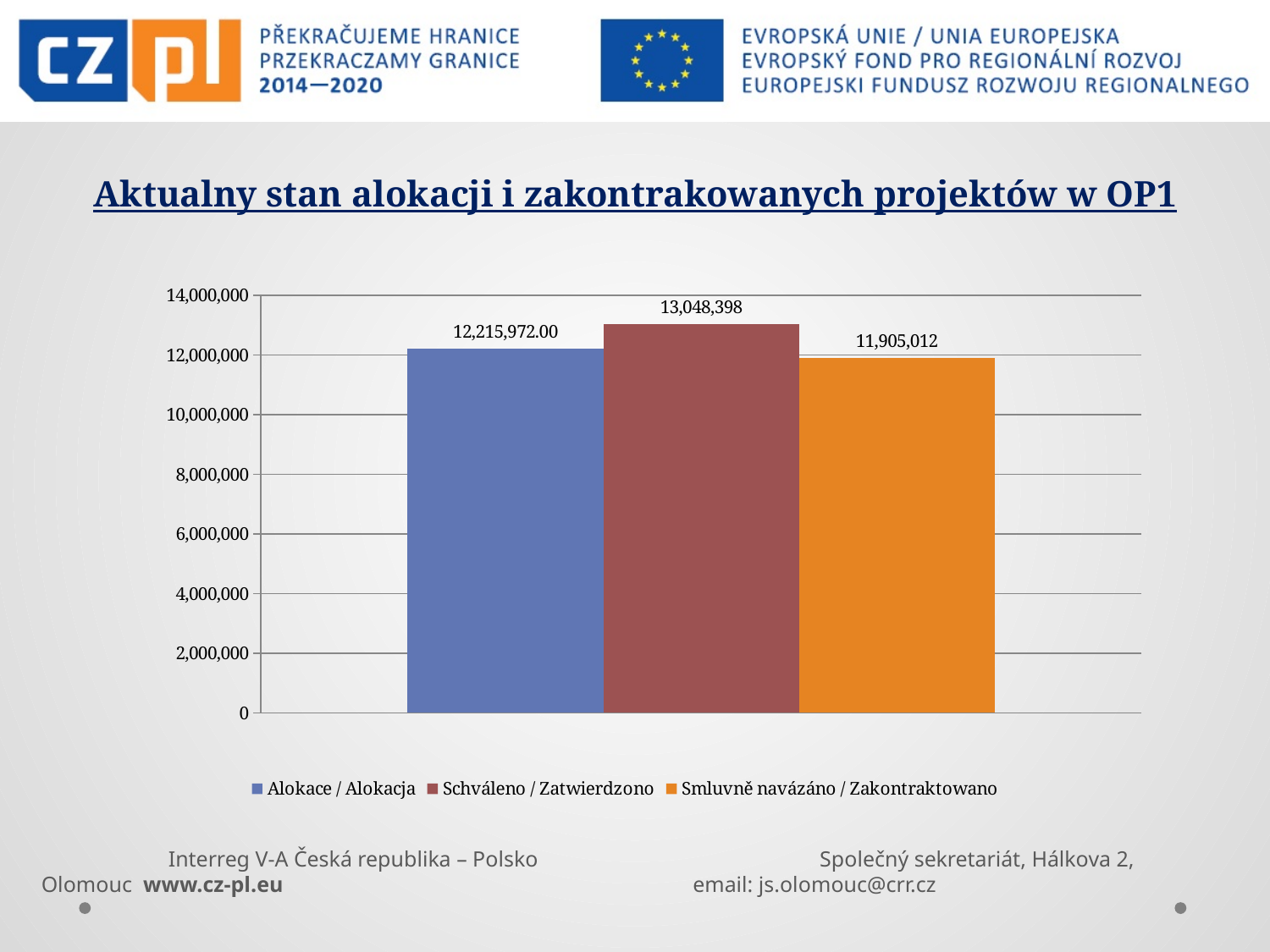
What is the difference between Schváleno / Zatwierdzono and Alokace / Alokacja? 832,426 What is the value for Smluvně navázáno / Zakontraktowano? 11,905,012 What is the value for Alokace / Alokacja? 12,215,972.00 Which series has the lowest value? Smluvně navázáno / Zakontraktowano What is the value for Schváleno / Zatwierdzono? 13,048,398 Is the value for Smluvně navázáno / Zakontraktowano greater or less than 12,000,000? less What kind of chart is shown on the slide? bar chart Which is larger, Schváleno / Zatwierdzono or Smluvně navázáno / Zakontraktowano? Schváleno / Zatwierdzono What is the difference between Alokace / Alokacja and Smluvně navázáno / Zakontraktowano? 310,960 How many series does the legend list? 3 Which series has the highest value? Schváleno / Zatwierdzono What is the title of the slide above the chart? Aktualny stan alokacji i zakontrakowanych projektów w OP1